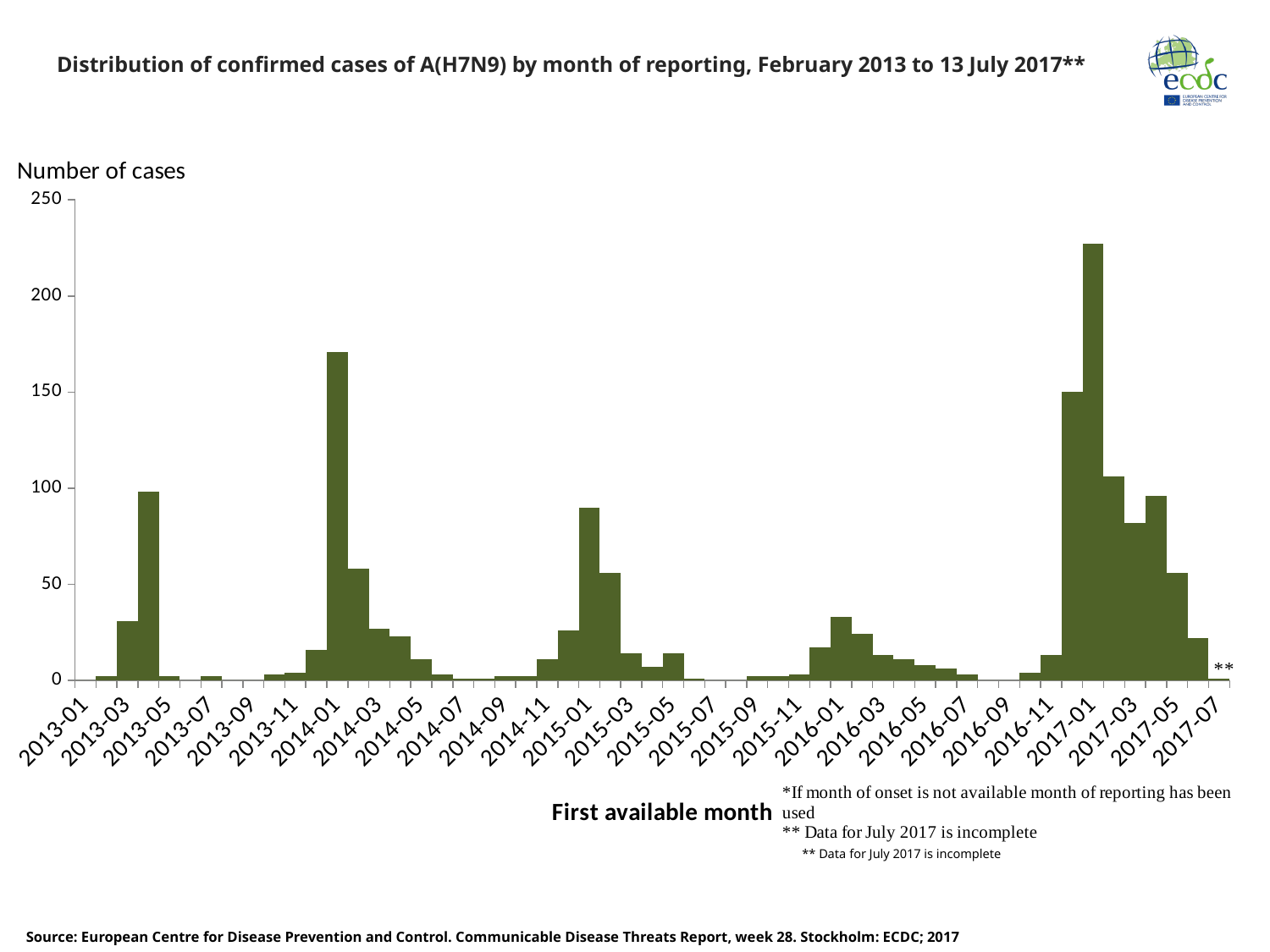
Is the number of cases for 2015-01 greater or less than 100? less Which month has more cases, 2014-01 or 2015-01? 2014-01 What is the label of the vertical axis? Number of cases Which month has the highest number of confirmed A(H7N9) cases? 2017-01 What is the label of the horizontal axis? First available month Is the number of cases for 2017-03 greater or less than 100? less Is the number of cases for 2013-04 greater or less than 50? greater Which month has more cases, 2017-01 or 2014-01? 2017-01 What kind of chart is shown on the slide? bar chart